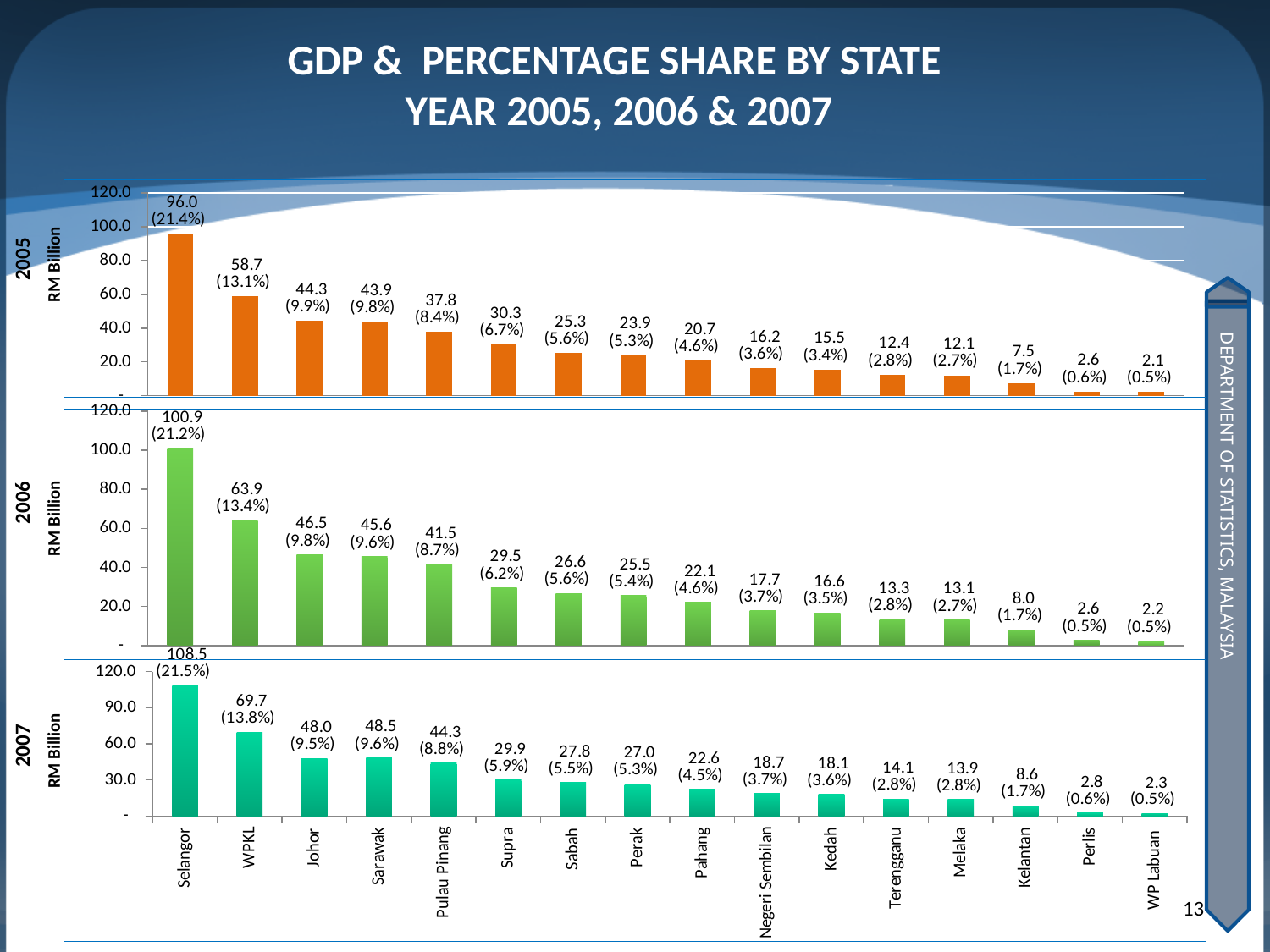
What is the y-axis label on each of the three charts? RM Billion In the 2006 chart, is the value for Selangor greater or less than 100.0? greater In the 2005 chart, what is the GDP value shown for Selangor? 96.0 In the 2006 chart, do the GDP values rise or fall from Selangor to WP Labuan along the x axis? Fall In the 2007 chart, what is the difference between the GDP values of Selangor and WPKL? 38.8 In the 2005 chart, which state has the lowest GDP value? WP Labuan In the 2007 chart, which state has the highest GDP value? Selangor What kind of chart is used to show GDP by state for each year? Bar chart How many states are shown along the x axis of the charts? 16 In the 2007 chart, what is the GDP value shown for Pulau Pinang? 44.3 In the 2007 chart, which has the larger GDP value, Johor or Sarawak? Sarawak In the 2006 chart, what percentage share is shown for WPKL? 13.4%